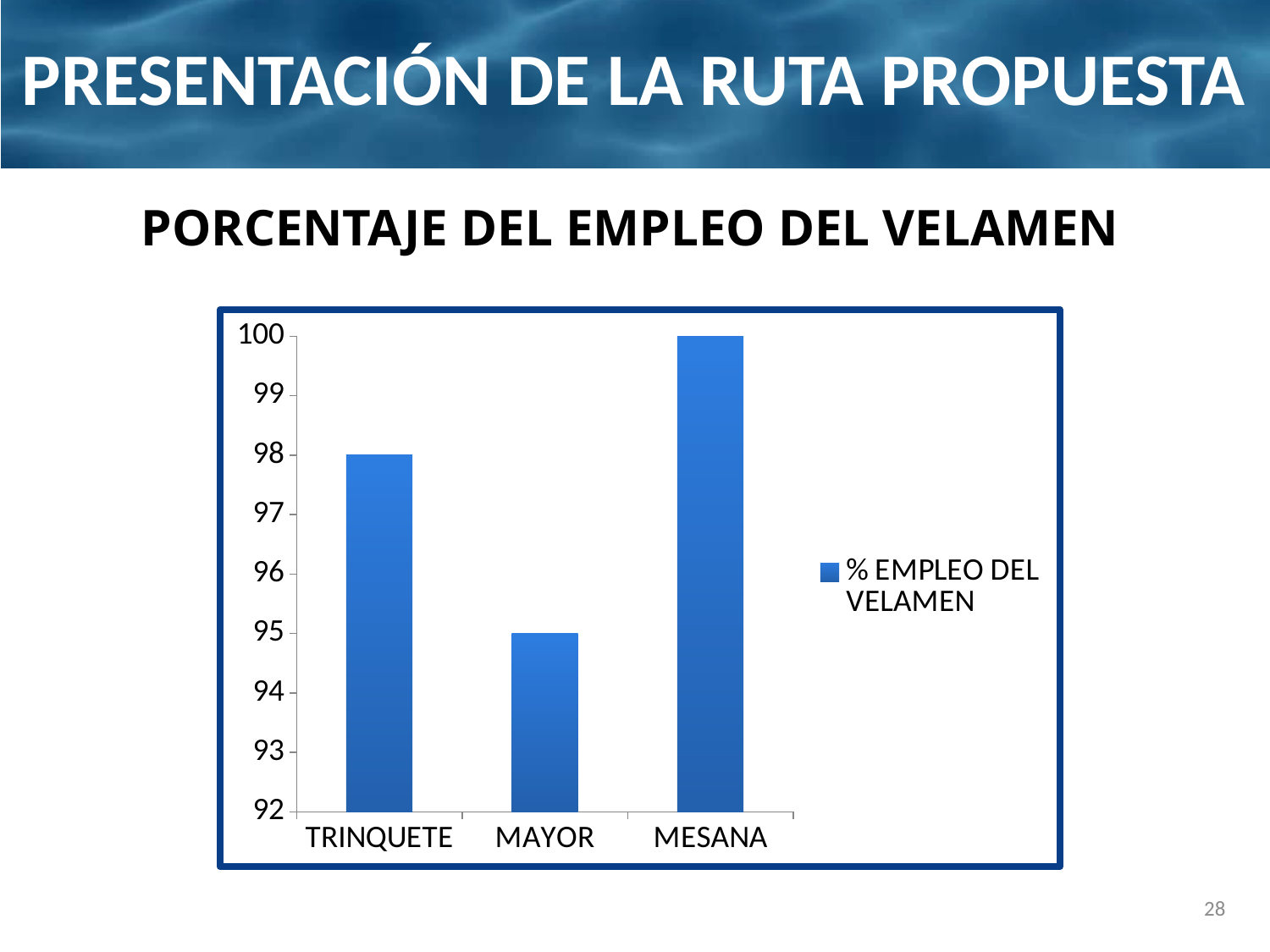
Is the value for MAYOR greater or less than 96? less Which category has the lowest value? MAYOR Which is larger, the value for TRINQUETE or the value for MAYOR? TRINQUETE What is the value for TRINQUETE? 98 Which category has the highest value? MESANA What is the value for MESANA? 100 What kind of chart is shown on the slide? bar chart What is the difference between the values for TRINQUETE and MAYOR? 3 What series name does the legend list? % EMPLEO DEL VELAMEN What is the difference between the values for MESANA and MAYOR? 5 How many categories are shown on the x axis? 3 What is the value for MAYOR? 95